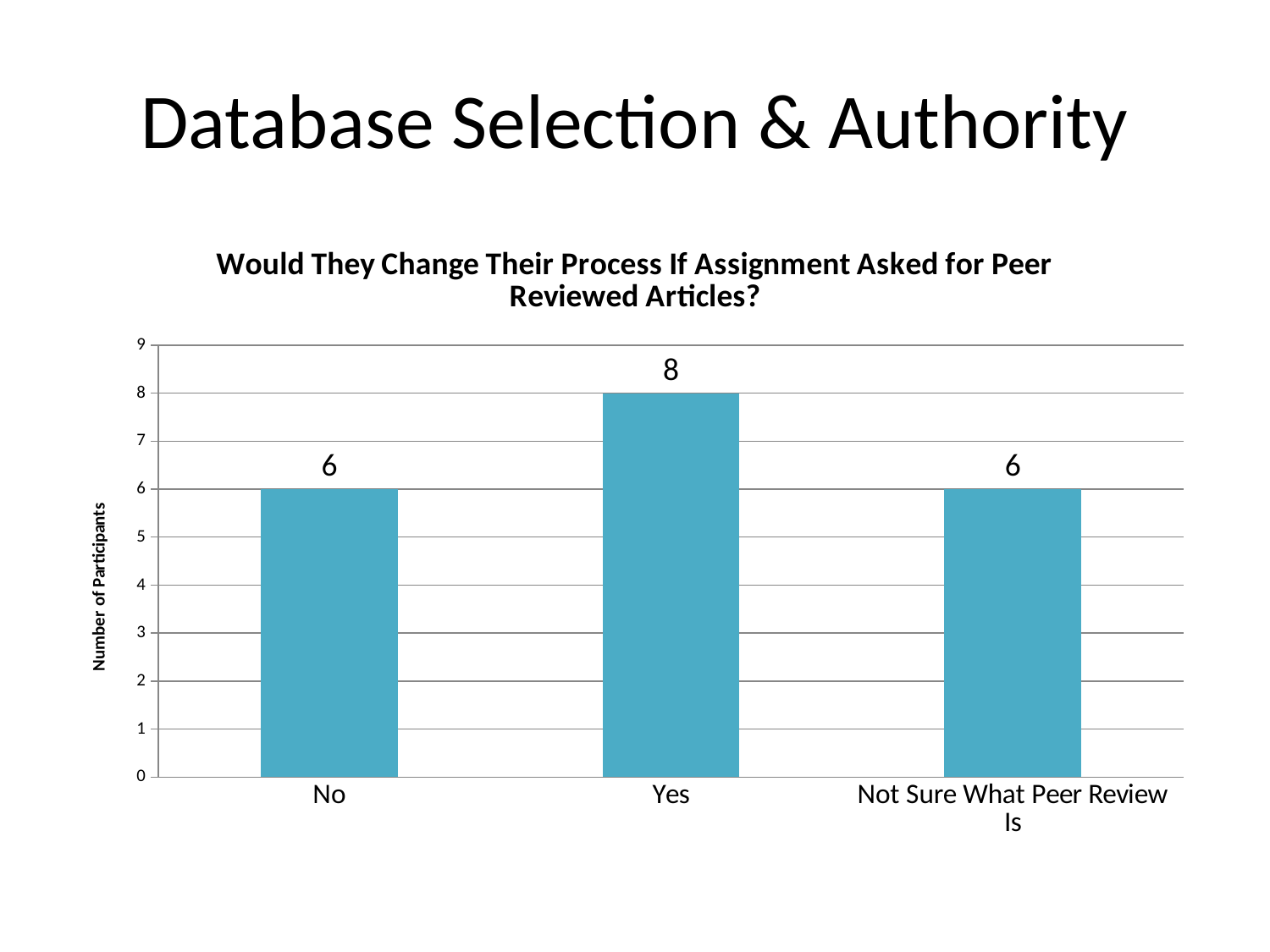
What is the title of the chart? Would They Change Their Process If Assignment Asked for Peer Reviewed Articles? What kind of chart is shown on the slide? bar chart What is the total number of participants across all three categories? 20 What is the number of participants in the "Not Sure What Peer Review Is" category? 6 Is the value for "Yes" greater or less than 7? greater What is the number of participants who answered "No"? 6 What is the difference in participants between "Yes" and "No"? 2 Which category has the highest number of participants? Yes Which has more participants, "Yes" or "Not Sure What Peer Review Is"? Yes What is the number of participants who answered "Yes"? 8 What is the label of the vertical axis? Number of Participants How many categories are shown on the x axis? 3